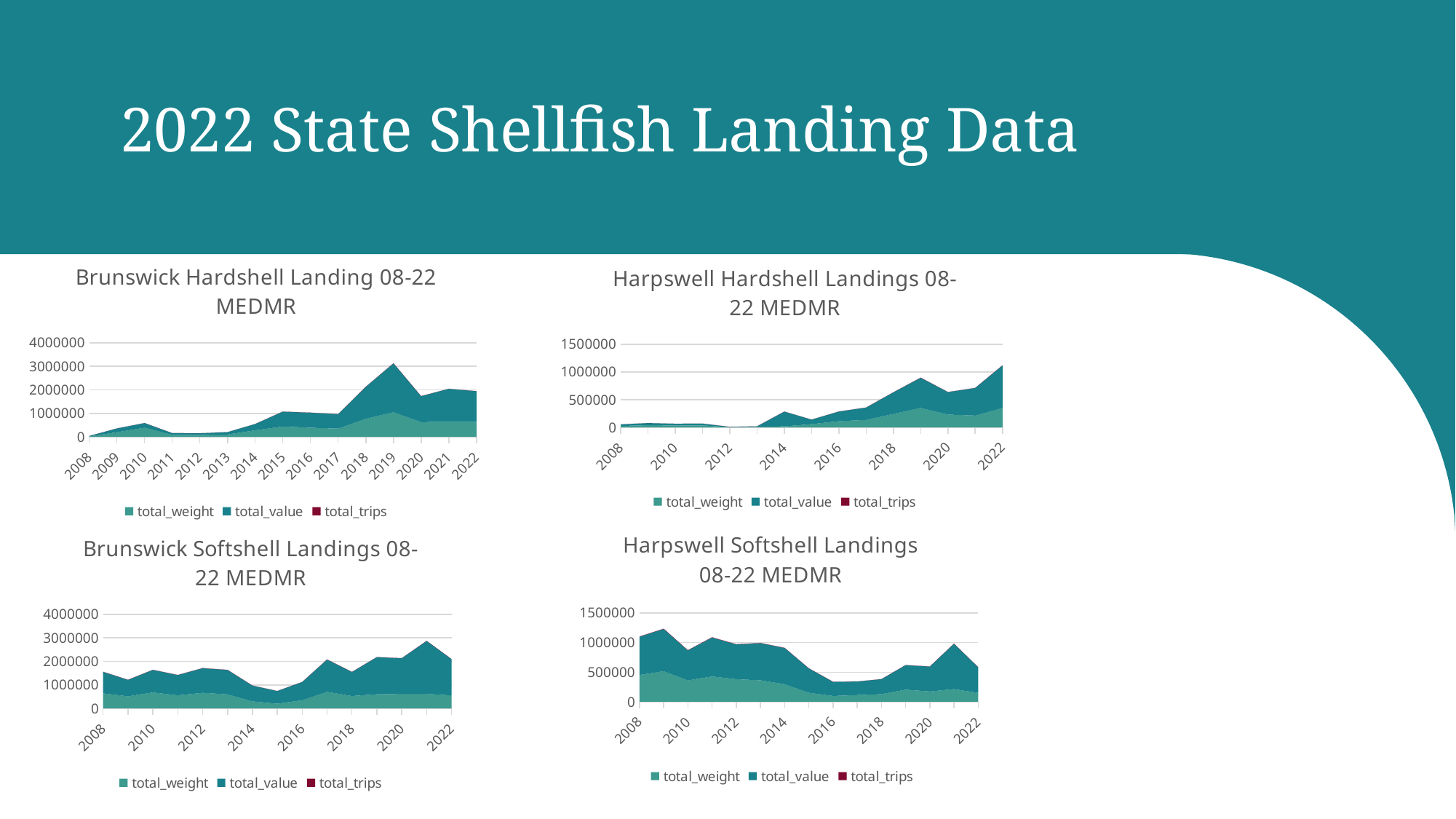
In the "Harpswell Softshell Landings 08-22 MEDMR" chart, is the stacked total for 2016 greater or less than 500000? less How many series does the legend of the "Harpswell Softshell Landings 08-22 MEDMR" chart list? 3 In the "Brunswick Hardshell Landing 08-22 MEDMR" chart, is the stacked total for 2019 greater or less than 2000000? greater What kind of chart is the "Brunswick Hardshell Landing 08-22 MEDMR" chart? Area chart In the "Brunswick Hardshell Landing 08-22 MEDMR" chart, which year has the highest stacked total? 2019 In the "Harpswell Hardshell Landings 08-22 MEDMR" chart, do the stacked totals generally rise or fall from 2008 to 2022? Rise In the "Harpswell Hardshell Landings 08-22 MEDMR" chart, is the stacked total for 2022 greater or less than 1000000? greater How many years are plotted along the x axis of the "Brunswick Hardshell Landing 08-22 MEDMR" chart? 15 In the "Harpswell Softshell Landings 08-22 MEDMR" chart, do the stacked totals generally rise or fall from 2008 to 2022? Fall In the "Brunswick Softshell Landings 08-22 MEDMR" chart, which year has the highest stacked total? 2021 In the "Harpswell Hardshell Landings 08-22 MEDMR" chart, which year has the highest stacked total? 2022